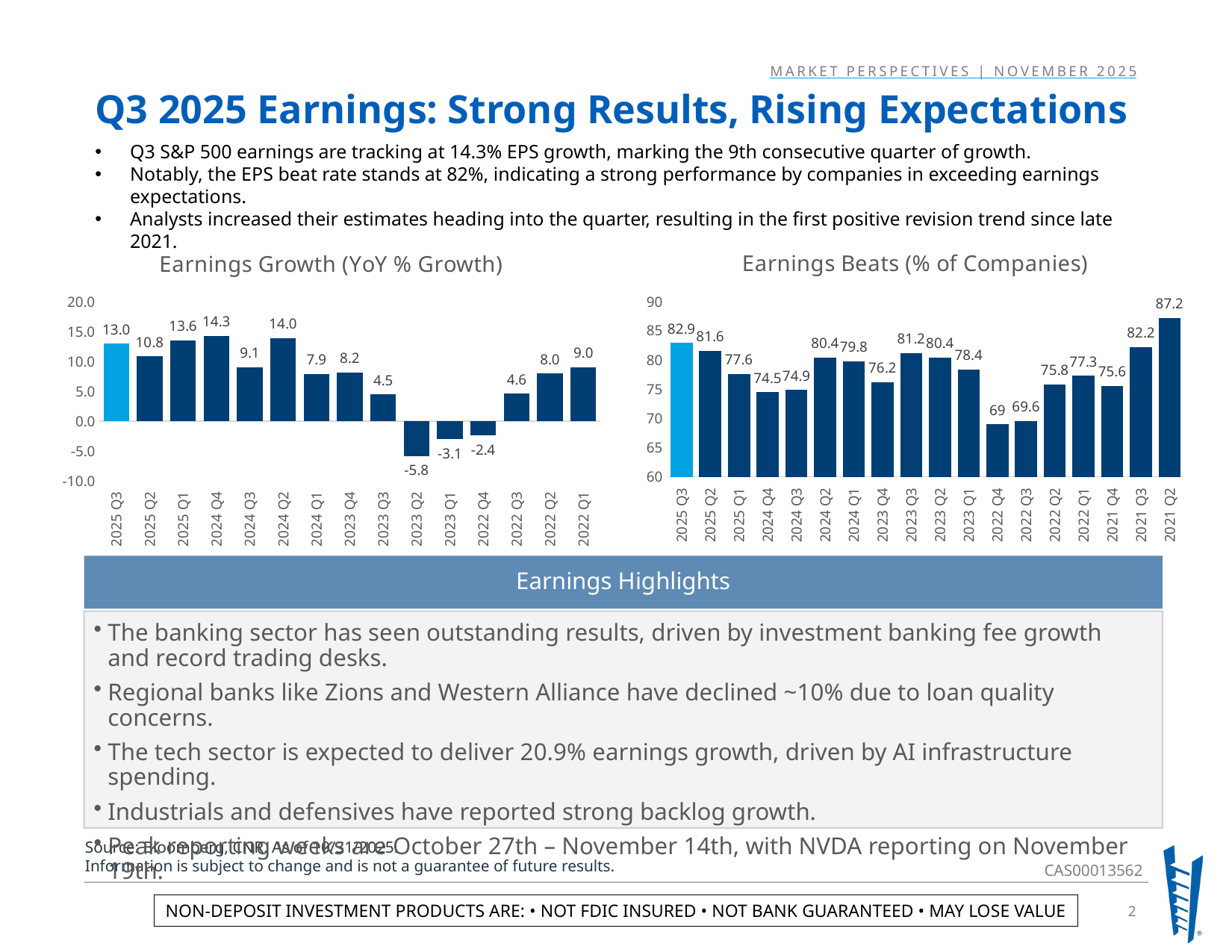
In the Earnings Growth (YoY % Growth) chart, which quarter has the highest value? 2024 Q4 In the Earnings Beats (% of Companies) chart, which quarter has the highest value? 2021 Q2 In the Earnings Beats (% of Companies) chart, how many quarters are plotted? 18 In the Earnings Growth (YoY % Growth) chart, what is the value for 2025 Q3? 13.0 In the Earnings Beats (% of Companies) chart, what is the difference between the values for 2021 Q2 and 2025 Q3? 4.3 In the Earnings Growth (YoY % Growth) chart, how many quarters are plotted? 15 In the Earnings Growth (YoY % Growth) chart, which is larger, the value for 2024 Q1 or 2023 Q4? 2023 Q4 In the Earnings Growth (YoY % Growth) chart, which quarter has the lowest value? 2023 Q2 What type of chart is the Earnings Beats (% of Companies) chart? Bar chart In the Earnings Growth (YoY % Growth) chart, what is the difference between the values for 2025 Q1 and 2025 Q2? 2.8 In the Earnings Beats (% of Companies) chart, what is the value for 2025 Q3? 82.9 In the Earnings Beats (% of Companies) chart, which quarter has the lowest value? 2022 Q4